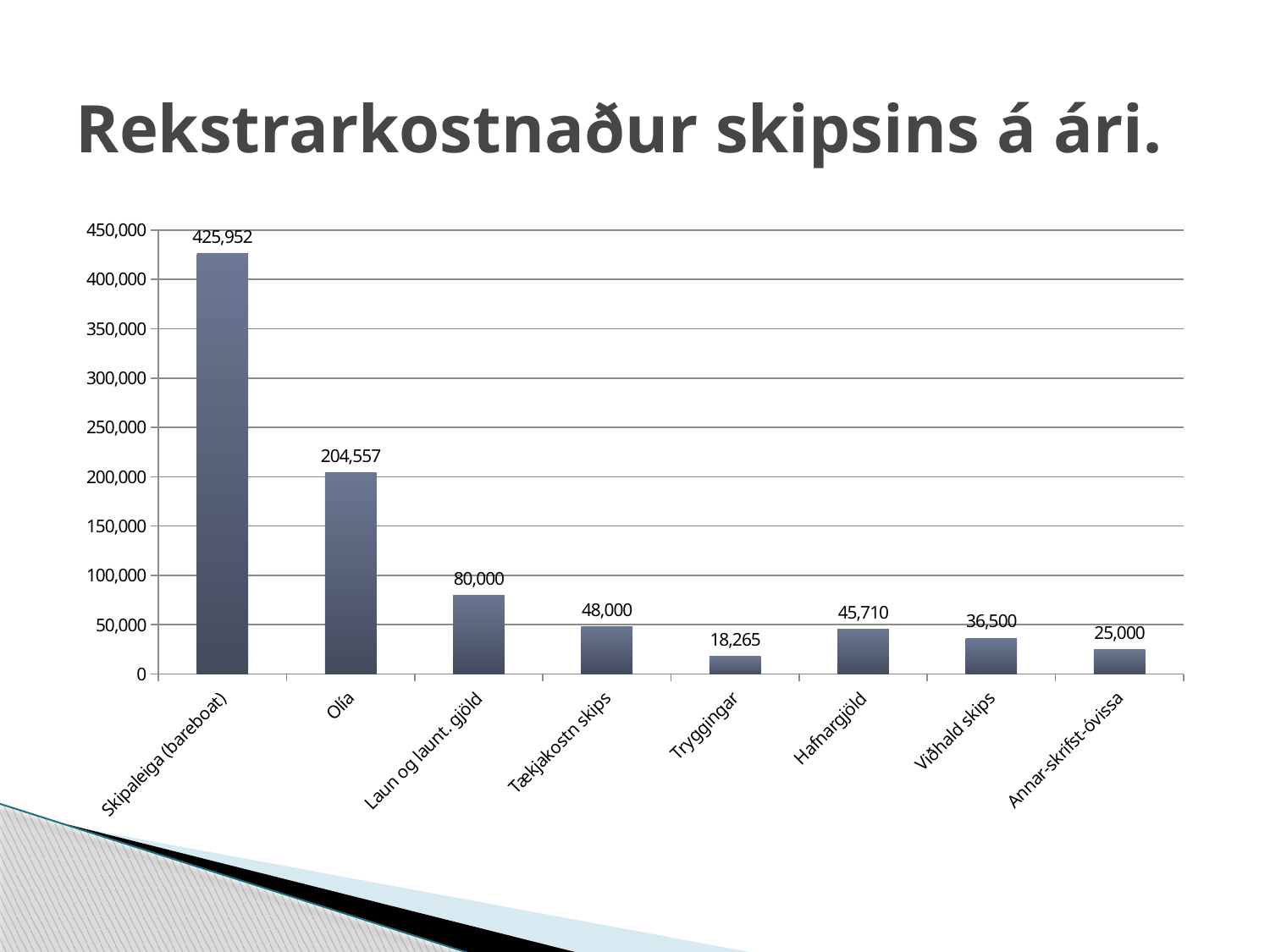
What is the value for Olía? 204,557 How many categories are shown in the chart? 8 Which category has the lowest value? Tryggingar What is the difference between the values for Laun og launt. gjöld and Tækjakostn skips? 32,000 Which category has the highest value? Skipaleiga (bareboat) What is the difference between the values for Skipaleiga (bareboat) and Olía? 221,395 What is the value for Hafnargjöld? 45,710 What is the value for Skipaleiga (bareboat)? 425,952 What is the value for Viðhald skips? 36,500 Which is larger, the value for Viðhald skips or the value for Annar-skrifst-óvissa? Viðhald skips Is the value for Olía greater or less than 200,000? greater What kind of chart is shown on the slide? bar chart